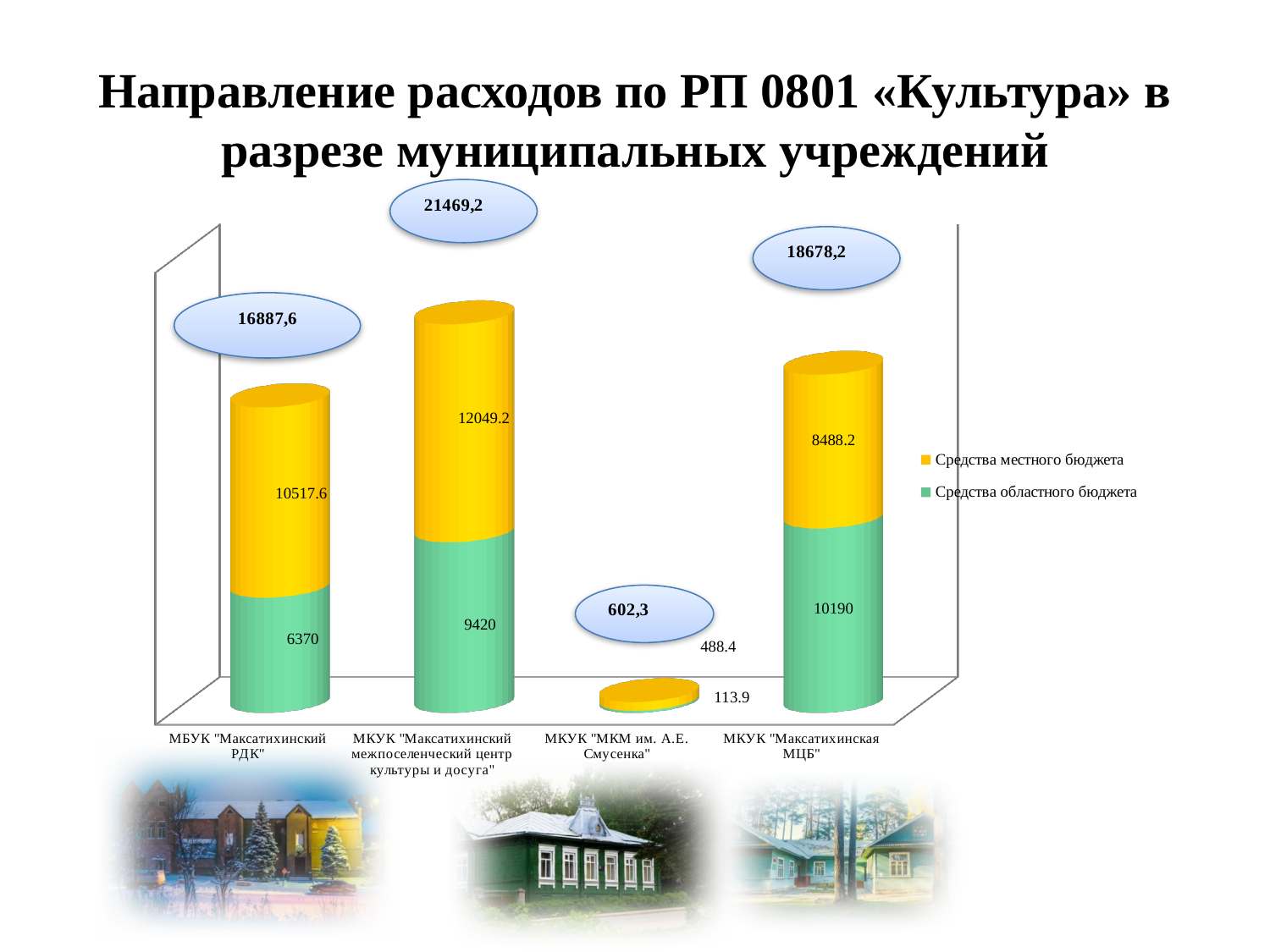
Which colour represents "Средства местного бюджета" in the chart? Yellow For МБУК "Максатихинский РДК", how much larger is "Средства местного бюджета" than "Средства областного бюджета"? 4147.6 What is the value of "Средства местного бюджета" for МКУК "Максатихинский межпоселенческий центр культуры и досуга"? 12049.2 Which institution has the lowest total expenditure? МКУК "МКМ им. А.Е. Смусенка" What kind of chart is shown on the slide? Stacked bar chart What is the value of "Средства областного бюджета" for МКУК "Максатихинская МЦБ"? 10190 Which has the larger "Средства областного бюджета" value: МКУК "Максатихинский межпоселенческий центр культуры и досуга" or МКУК "Максатихинская МЦБ"? МКУК "Максатихинская МЦБ" What is the value of "Средства местного бюджета" for МБУК "Максатихинский РДК"? 10517.6 Which institution has the highest total expenditure? МКУК "Максатихинский межпоселенческий центр культуры и досуга" What is the total shown for МКУК "МКМ им. А.Е. Смусенка"? 602,3 How many institutions are shown on the chart? 4 How many series does the legend list? 2